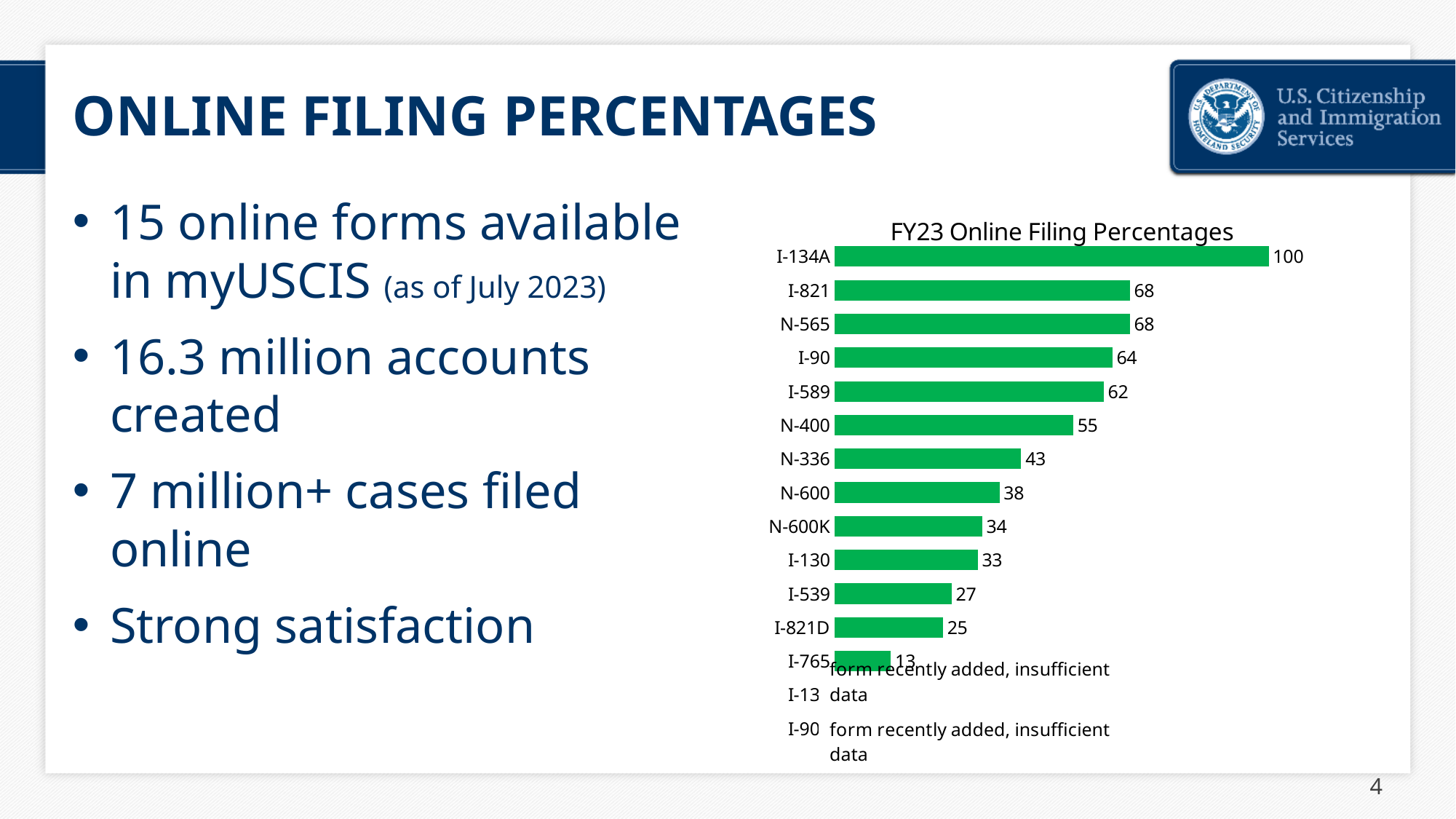
What is the difference between the values for N-400 and N-336? 12 Among the forms with a plotted bar, which has the lowest online filing percentage? I-765 What is the value shown for I-539? 27 Which form has the highest online filing percentage? I-134A What is the value shown for N-600K? 34 What kind of chart is shown on the slide? bar chart What is the difference between the values for I-134A and I-821? 32 Which has a larger value, N-600 or I-130? N-600 What is the title of the chart? FY23 Online Filing Percentages What is the FY23 online filing percentage for I-134A? 100 How many forms have a bar with a value plotted in the chart? 13 What is the value shown for N-400? 55